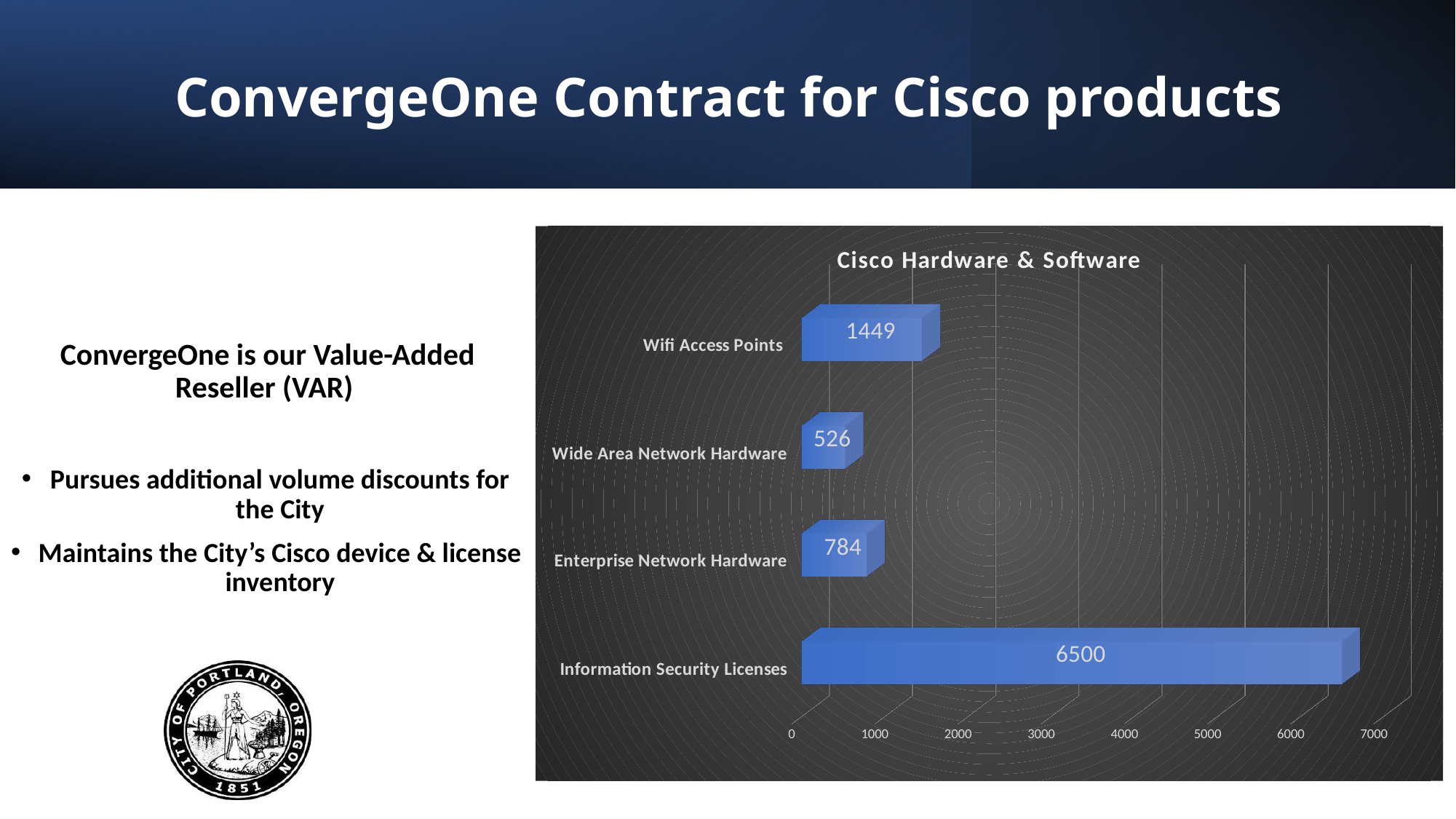
What is the value for Enterprise Network Hardware? 784 What is the value for Information Security Licenses? 6500 What is the title of the chart? Cisco Hardware & Software What is the difference between Enterprise Network Hardware and Wide Area Network Hardware? 258 Which is larger, Wifi Access Points or Enterprise Network Hardware? Wifi Access Points What is the value for Wifi Access Points? 1449 Which category has the highest value? Information Security Licenses What is the difference between Information Security Licenses and Wifi Access Points? 5051 What kind of chart is shown on the slide? Bar chart How many categories are shown in the chart? 4 Which category has the lowest value? Wide Area Network Hardware What is the value for Wide Area Network Hardware? 526